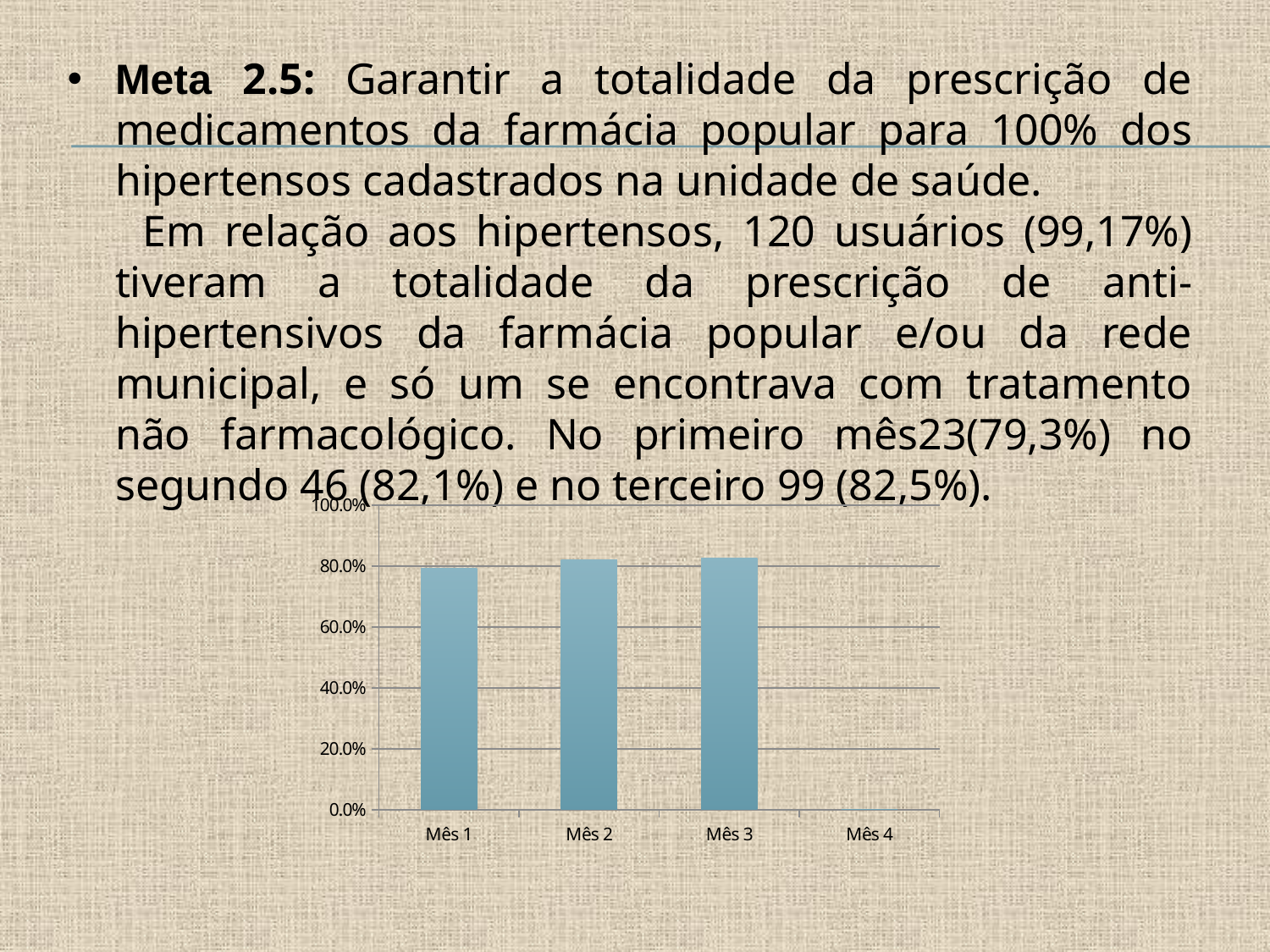
Which category has the lowest value in the chart? Mês 4 Is the value for Mês 4 greater or less than 20.0%? less Which is larger, the value for Mês 3 or the value for Mês 4? Mês 3 What kind of chart is shown on the slide? bar chart What is the label of the first category on the x axis? Mês 1 Is the value for Mês 2 greater or less than 60.0%? greater How many categories are plotted on the x axis of the chart? 4 Is the value for Mês 3 greater or less than 100.0%? less What is the highest tick label shown on the y axis of the chart? 100.0% Does the value rise or fall from Mês 3 to Mês 4? fall Which is larger, the value for Mês 1 or the value for Mês 4? Mês 1